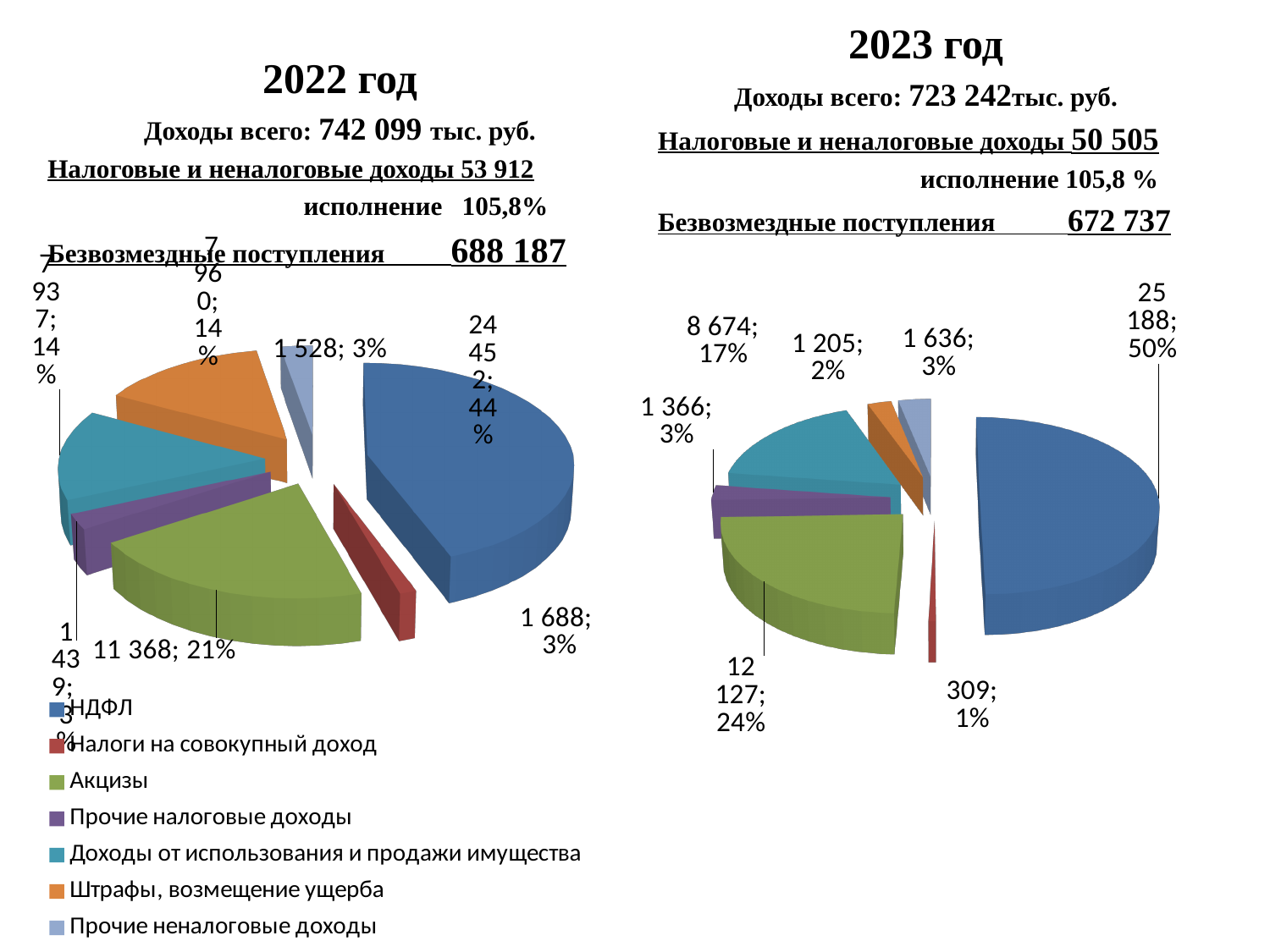
In the 2023 год chart, which category has the smallest slice? Налоги на совокупный доход Which legend entry is shown in orange? Штрафы, возмещение ущерба In the 2022 год chart, what is the value shown for Акцизы? 11 368; 21% In the 2023 год chart, what is the difference between the values for НДФЛ and Акцизы? 13 061 In the 2023 год chart, what is the value shown for Налоги на совокупный доход? 309; 1% In the 2023 год chart, which category has the largest slice? НДФЛ What type of chart is used for the 2022 год chart? pie chart In the 2022 год chart, which is larger: Акцизы or Налоги на совокупный доход? Акцизы In the 2023 год chart, what is the value shown for НДФЛ? 25 188; 50% How many categories does the legend list for the pie charts? 7 In the 2022 год chart, what share of the pie does НДФЛ have? 44% In the 2023 год chart, what share of the pie does Доходы от использования и продажи имущества have? 17%